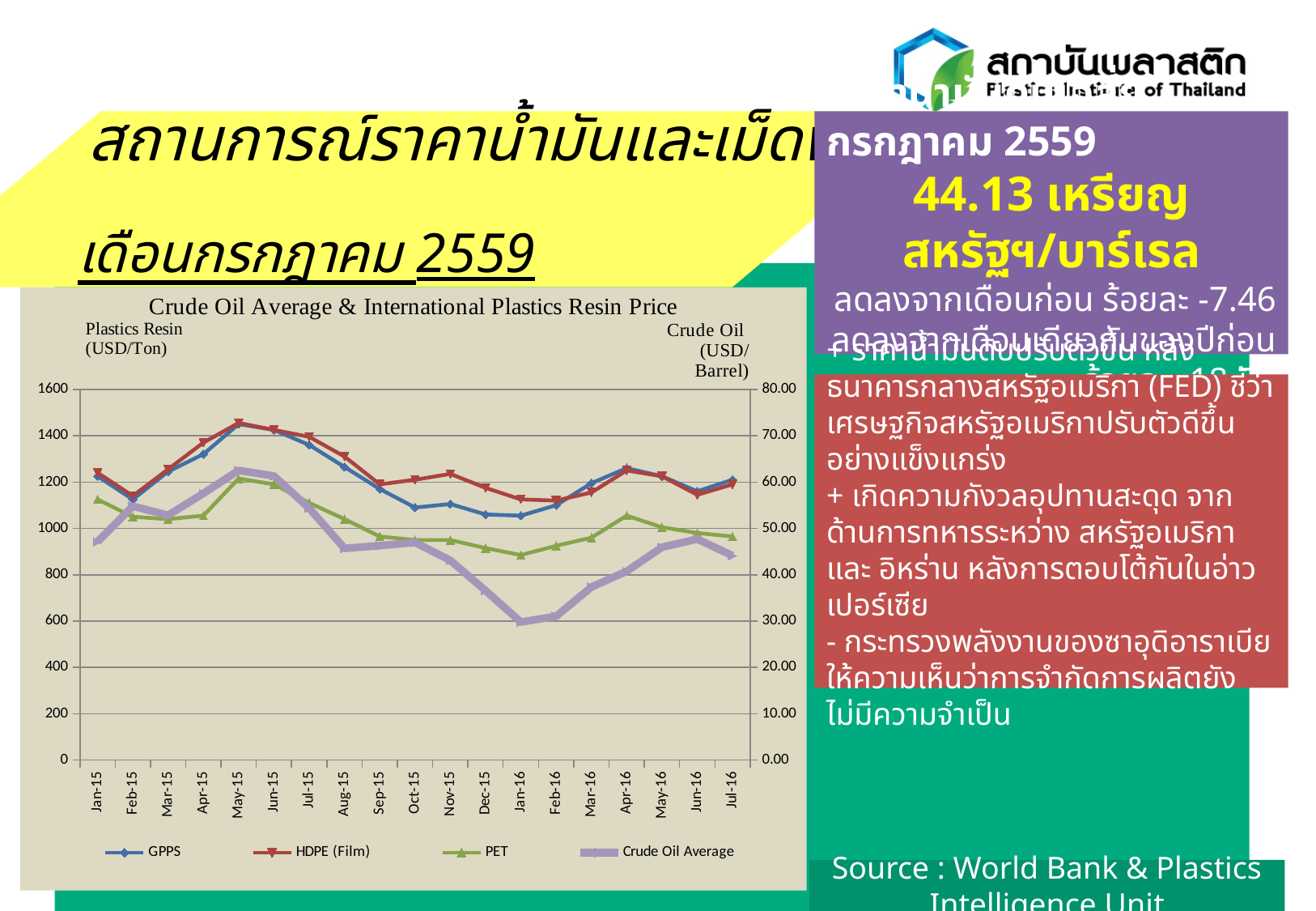
How many series does the chart legend list? 4 In which month does the Crude Oil Average series reach its highest point? May-15 In which month does the PET series reach its lowest point? Jan-16 In which month does the PET series reach its highest point? May-15 Is the value for PET in Jan-16 greater or less than 1000? less Which series in the chart is plotted against the right-hand axis (USD/Barrel)? Crude Oil Average How many months are plotted along the x axis of the chart? 19 Is the value for Crude Oil Average in Jan-16 greater or less than 40.00? less In which month does the Crude Oil Average series reach its lowest point? Jan-16 What kind of chart is shown on the slide? Line chart Which is larger in Jan-16, HDPE (Film) or PET? HDPE (Film) What is the title of the chart? Crude Oil Average & International Plastics Resin Price